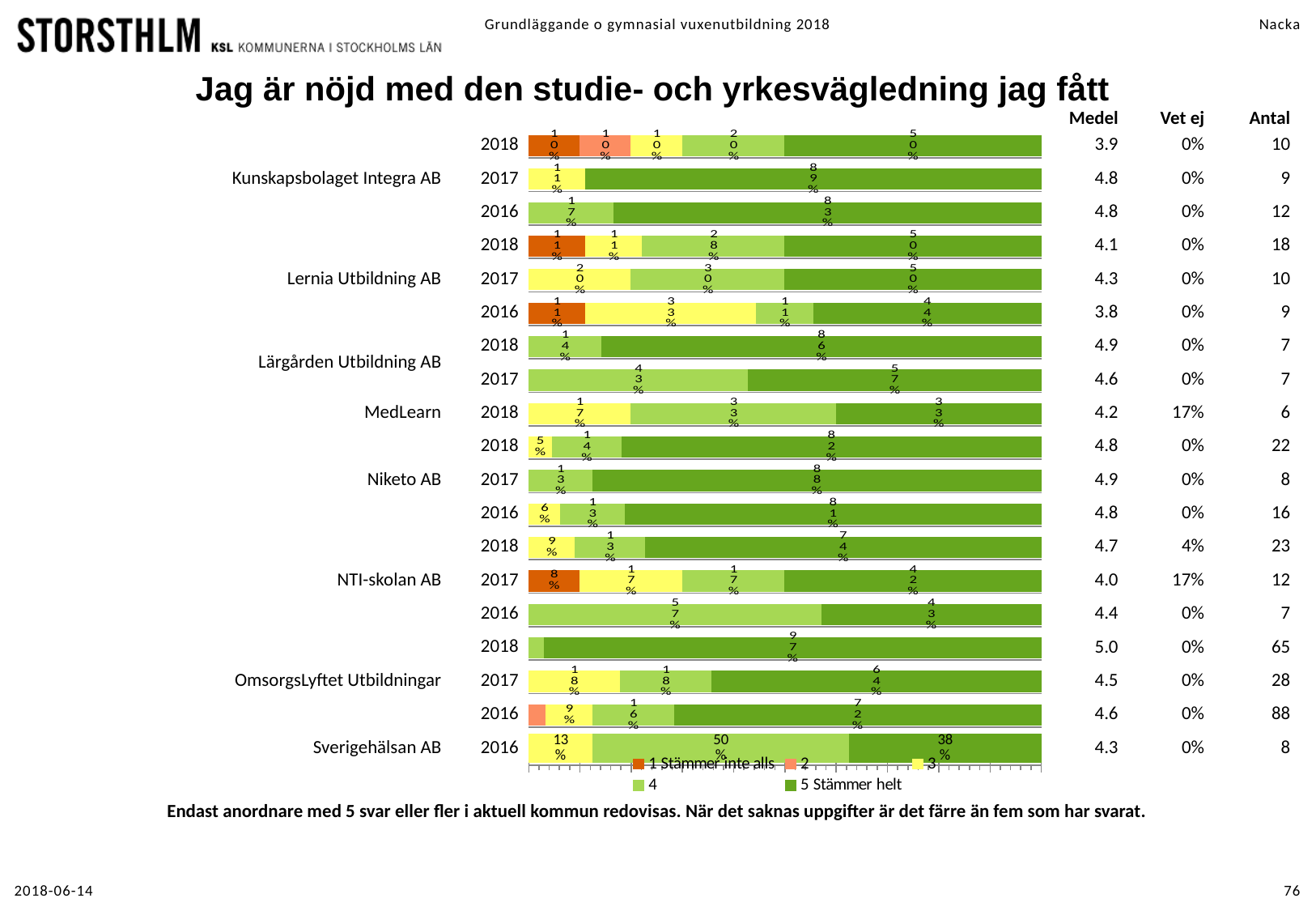
How many series does the legend list? 5 What percentage of respondents for NTI-skolan AB in 2016 answered 4? 57% What percentage of respondents for Lärgården Utbildning AB in 2017 answered 5 Stämmer helt? 57% What percentage of respondents for Sverigehälsan AB in 2016 answered 5 Stämmer helt? 38% What is the title of the chart? Jag är nöjd med den studie- och yrkesvägledning jag fått What kind of chart is shown on the slide? bar chart Which legend entry is shown in dark green? 5 Stämmer helt What percentage of respondents for OmsorgsLyftet Utbildningar in 2018 answered 5 Stämmer helt? 97% For Sverigehälsan AB in 2016, which is larger: the share answering 4 or the share answering 5 Stämmer helt? 4 For Sverigehälsan AB in 2016, what is the difference between the share answering 4 and the share answering 3? 37% What percentage of respondents for Sverigehälsan AB in 2016 answered 4? 50% What percentage of respondents for Kunskapsbolaget Integra AB in 2018 answered 5 Stämmer helt? 50%